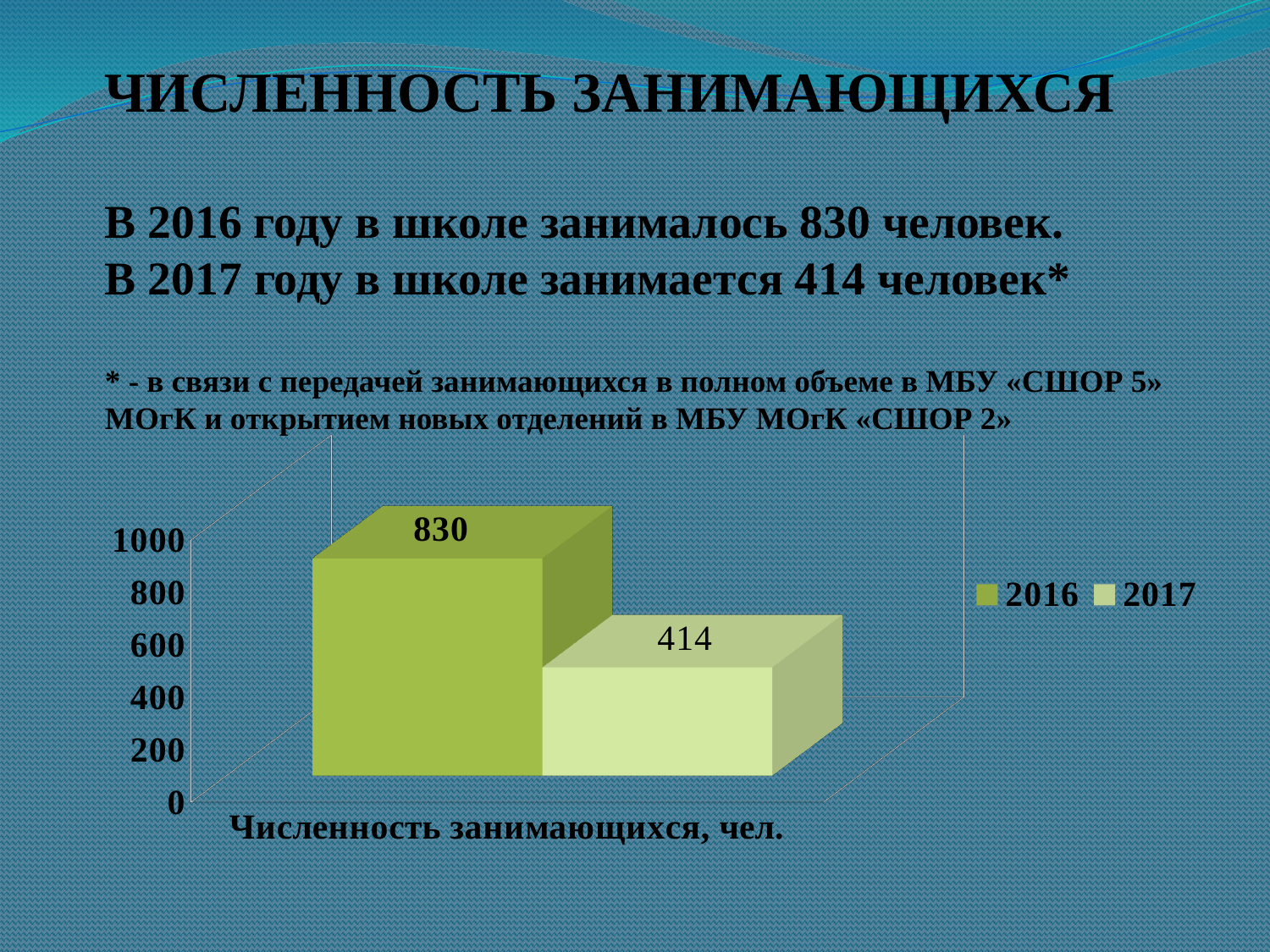
What is the difference between the 2016 and 2017 values? 416 Did the number of participants rise or fall from 2016 to 2017? fall What is the category label shown under the bars? Численность занимающихся, чел. What kind of chart is shown on the slide? bar chart What is the value for 2017 in the chart? 414 Is the value for 2017 greater or less than 600? less Is the value for 2016 greater or less than 800? greater What is the highest value shown on the vertical axis? 1000 Which series has the higher value, 2016 or 2017? 2016 What is the value for 2016 in the chart? 830 How many series does the legend list? 2 Which year has the lowest value in the chart? 2017